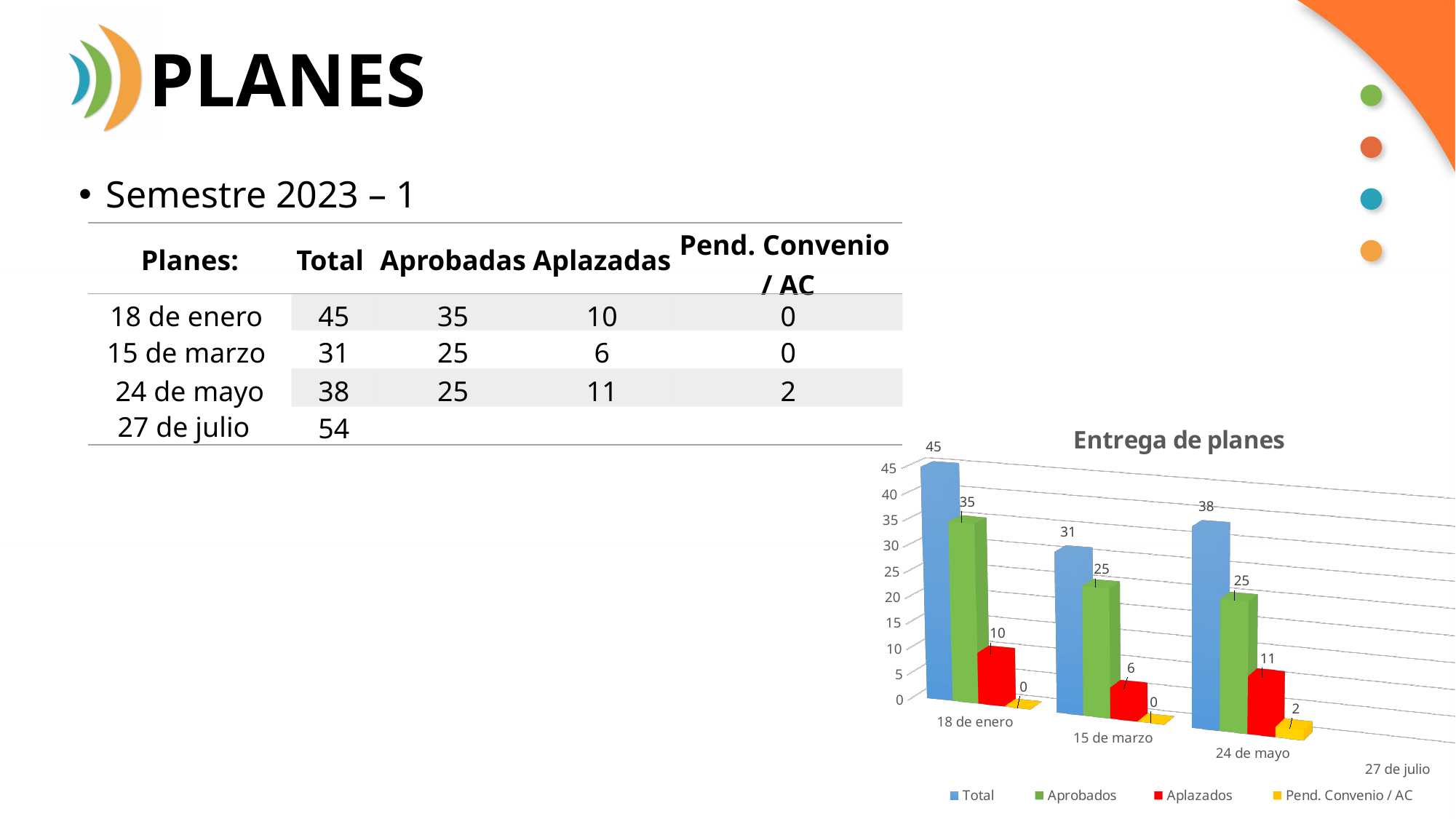
How many series does the legend of the chart list? 4 What is the title of the chart? Entrega de planes What is the Pend. Convenio / AC value for 24 de mayo in the chart? 2 What is the difference between the Total values for 18 de enero and 15 de marzo in the chart? 14 What is the Aplazados value for 24 de mayo in the chart? 11 What is the Total value for 18 de enero in the chart? 45 What is the Aprobados value for 15 de marzo in the chart? 25 Which date has the lowest Aplazados value in the chart? 15 de marzo What kind of chart is 'Entrega de planes'? bar chart Which date has the highest Total value in the chart? 18 de enero Which is larger in the chart: the Aprobados value for 18 de enero or for 24 de mayo? 18 de enero Which colour represents the Aplazados series in the chart? red